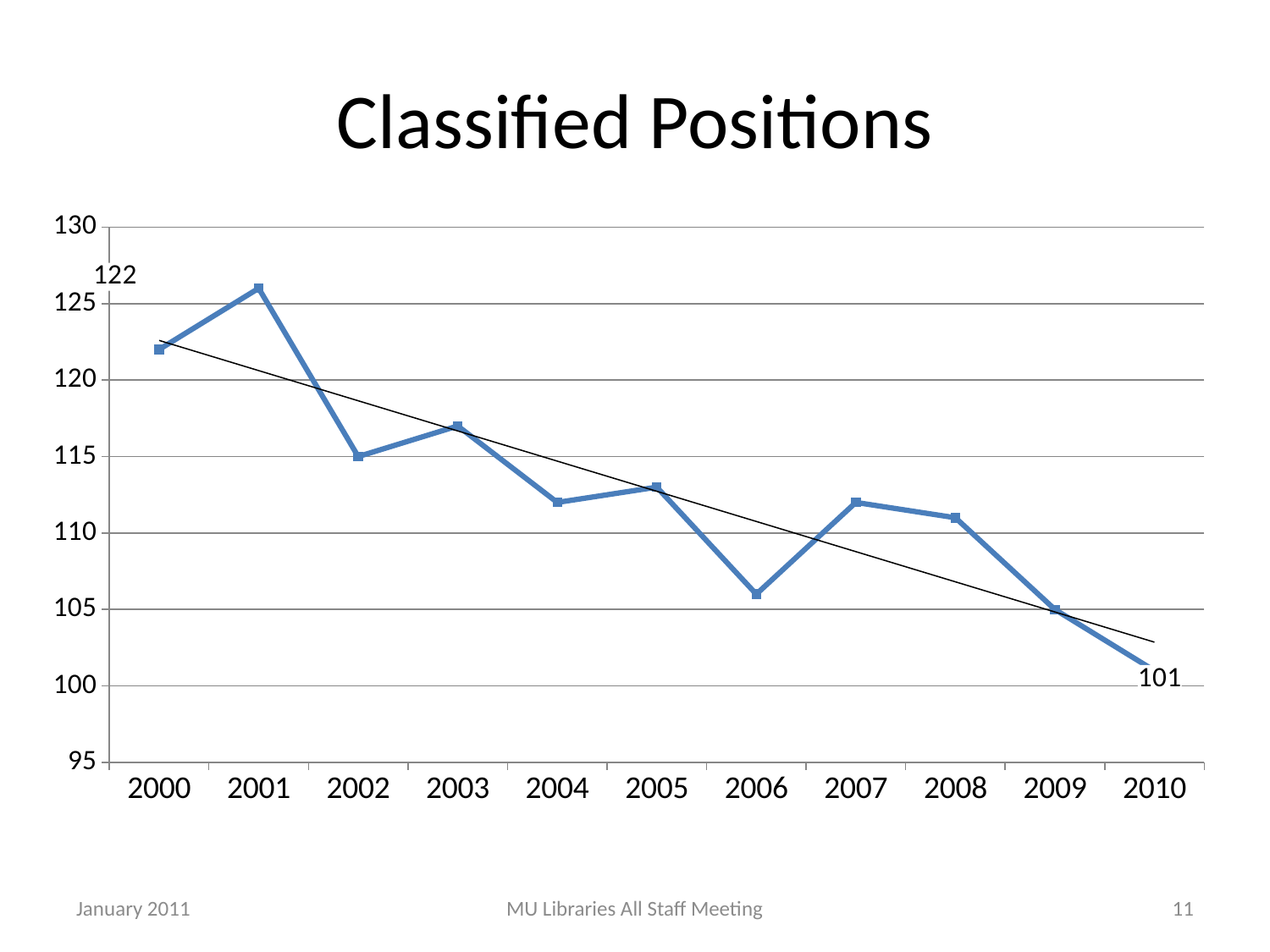
Do the values generally rise or fall from 2000 to 2010? fall What is the value for 2010? 101 Is the value for 2001 greater or less than 125? greater What is the value for 2000? 122 What type of chart is shown on the slide? line chart What is the title of the chart? Classified Positions Which year has the lowest value? 2010 Which year has the highest value? 2001 How many years are plotted on the x axis? 11 What is the difference between the values for 2000 and 2010? 21 Is the value for 2006 greater or less than 110? less Which is larger, the value for 2001 or the value for 2006? 2001